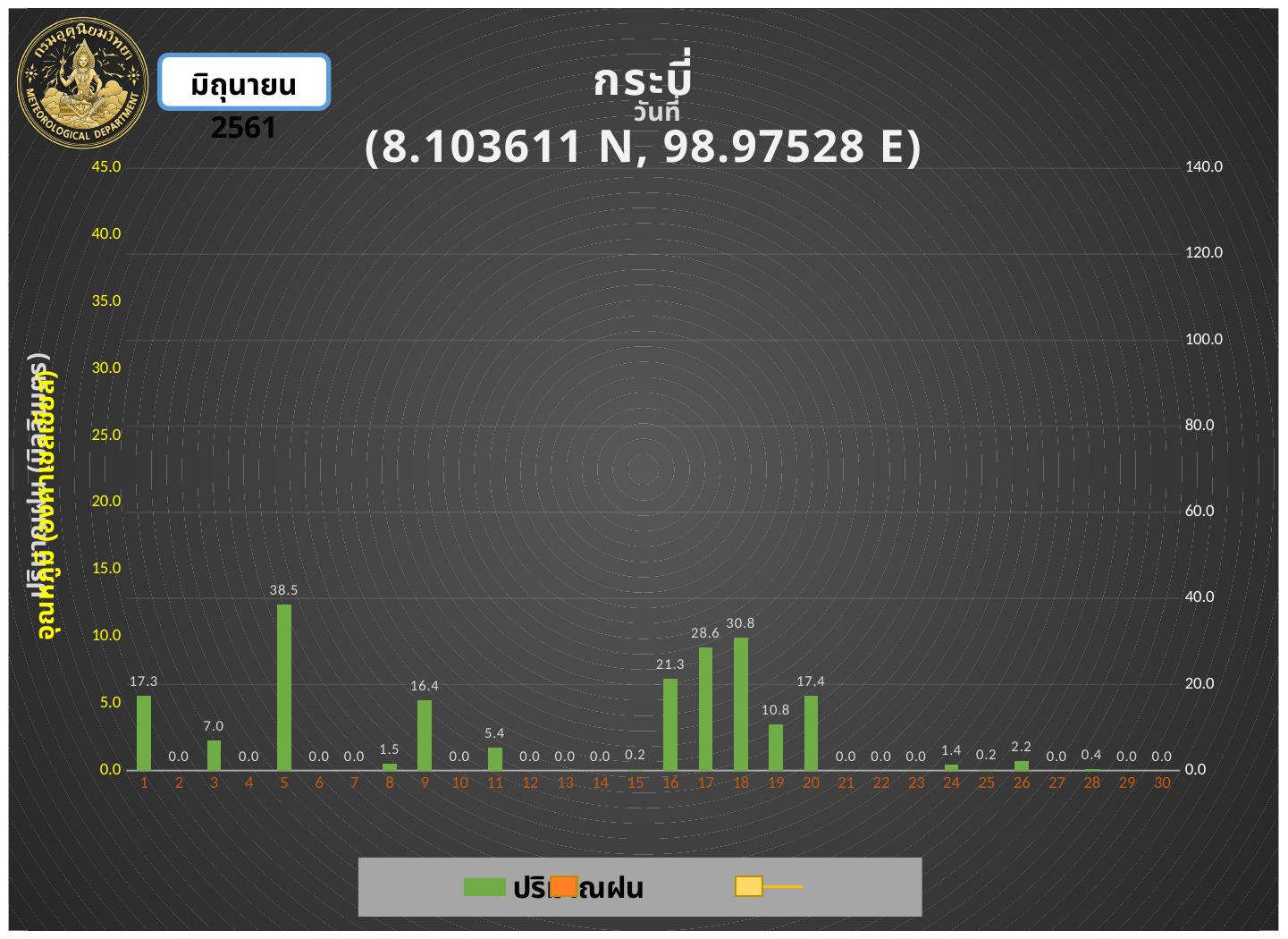
What is the difference between the values for day 18 and day 17? 2.2 What is the value for day 26? 2.2 What is the difference between the values for day 5 and day 16? 17.2 What is the title of the chart? กระบี่ (8.103611 N, 98.97528 E) Which day has the highest value? 5 Which is larger, the value for day 1 or the value for day 20? day 20 What is the value for day 9? 16.4 How many days are shown on the x axis? 30 Which is larger, the value for day 3 or the value for day 11? day 3 What kind of chart is shown on the slide? bar chart What is the value for day 5? 38.5 What is the value for day 17? 28.6